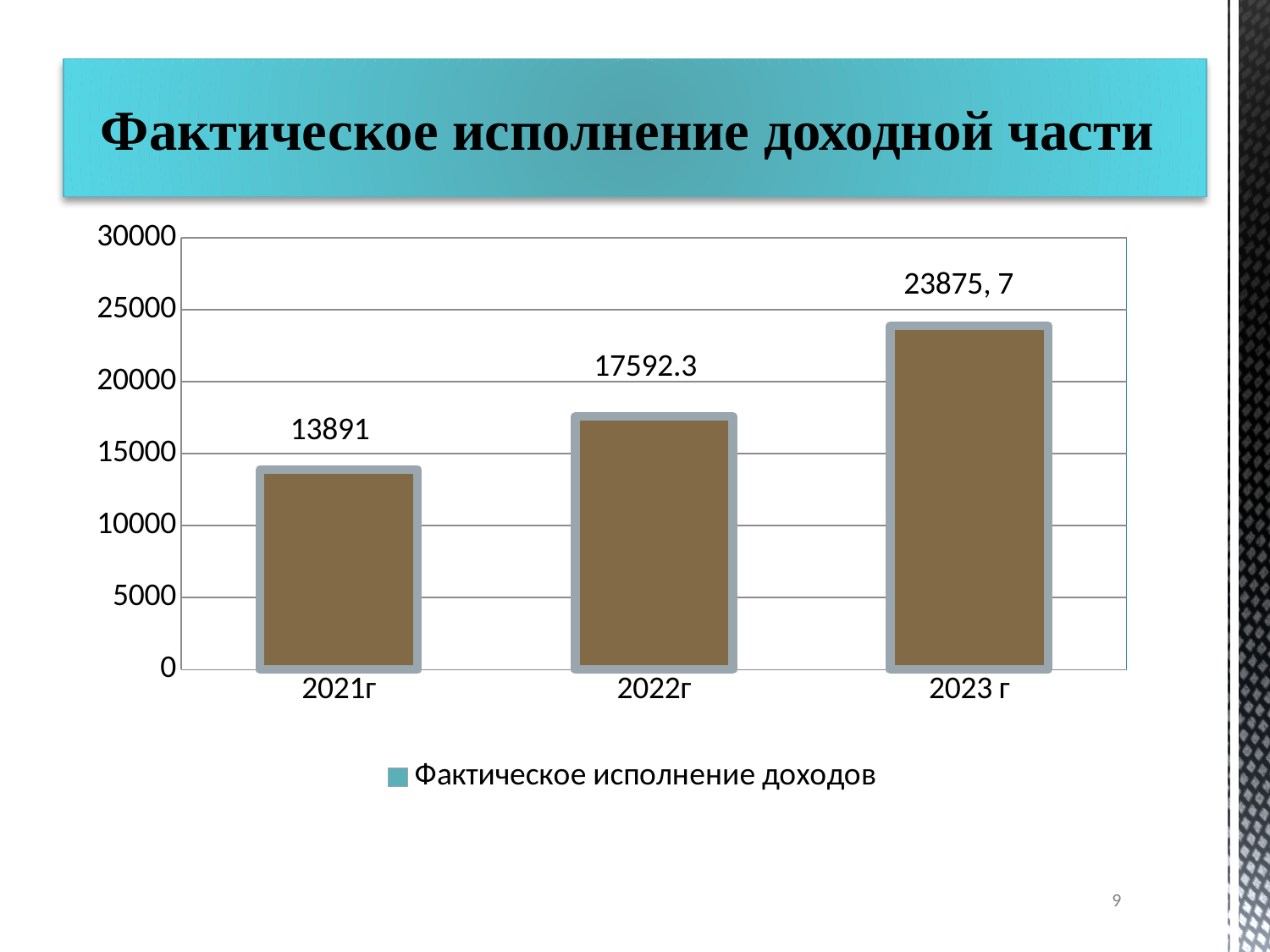
Do the values rise or fall from 2021г to 2023 г? rise Which year has the lowest value? 2021г What is the difference between the values for 2022г and 2021г? 3701.3 What is the value for 2021г? 13891 How many bars are shown in the chart? 3 Which is larger, the value for 2022г or the value for 2021г? 2022г What kind of chart is shown on the slide? bar chart What is the data label shown above the bar for 2023 г? 23875, 7 Which year has the highest value? 2023 г What is the value for 2022г? 17592.3 How many series does the legend list? 1 Is the value for 2023 г greater or less than 20000? greater